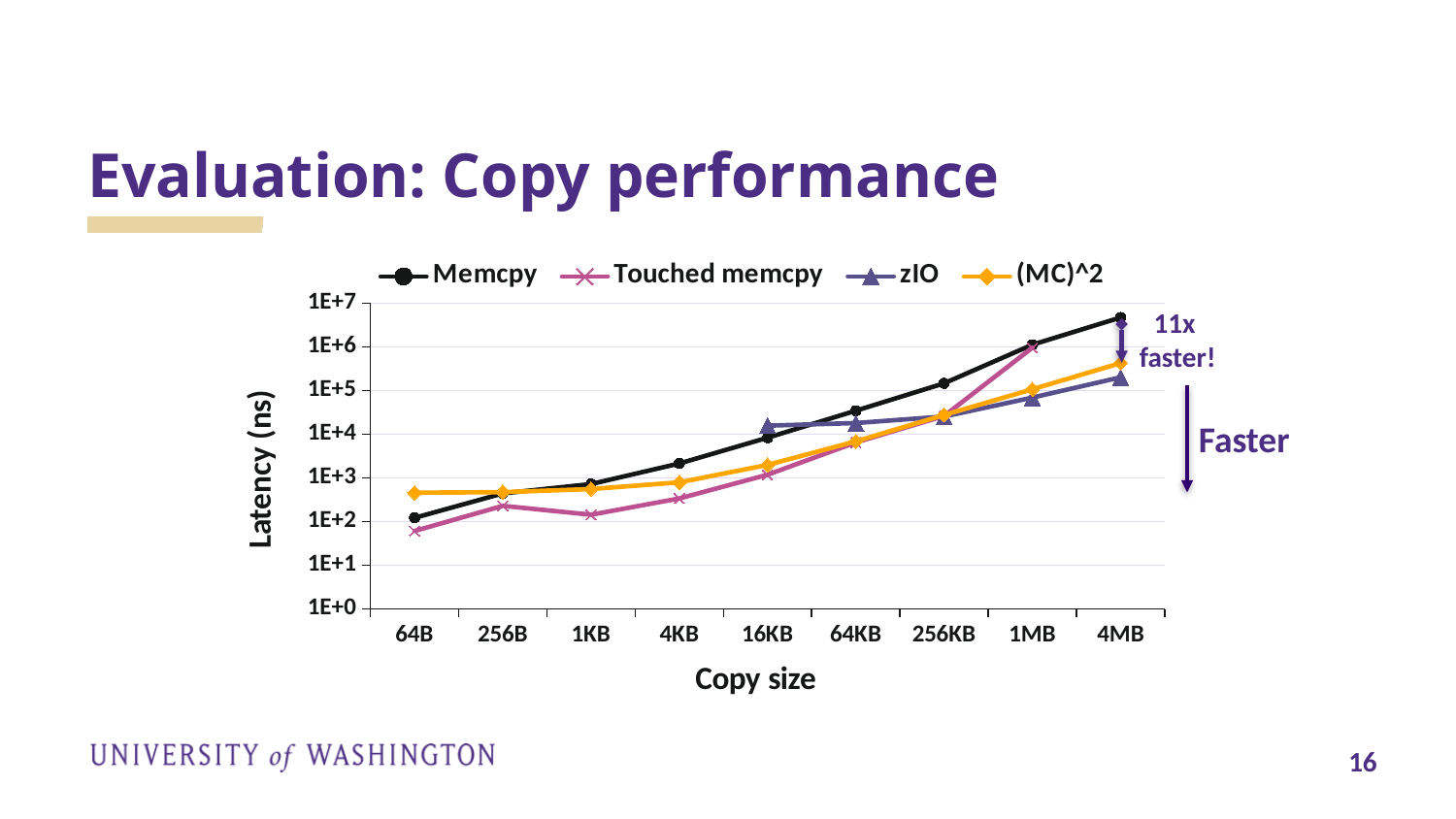
How many copy sizes are shown on the x axis? 9 Which series has the highest latency at 4MB? Memcpy At 16KB, which has the higher latency, zIO or Touched memcpy? zIO Which series has the lowest latency at 4MB? zIO Is the latency for Memcpy at 4MB greater or less than 1E+6? greater Which series has the lowest latency at 64B? Touched memcpy What kind of chart is shown on the slide? line chart Is the latency for zIO at 4MB greater or less than 1E+6? less How many series does the legend list? 4 What is the title of the y axis? Latency (ns) Is the latency for (MC)^2 at 64B greater or less than 1E+2? greater Does the Memcpy latency rise or fall as copy size increases along the x axis? rise